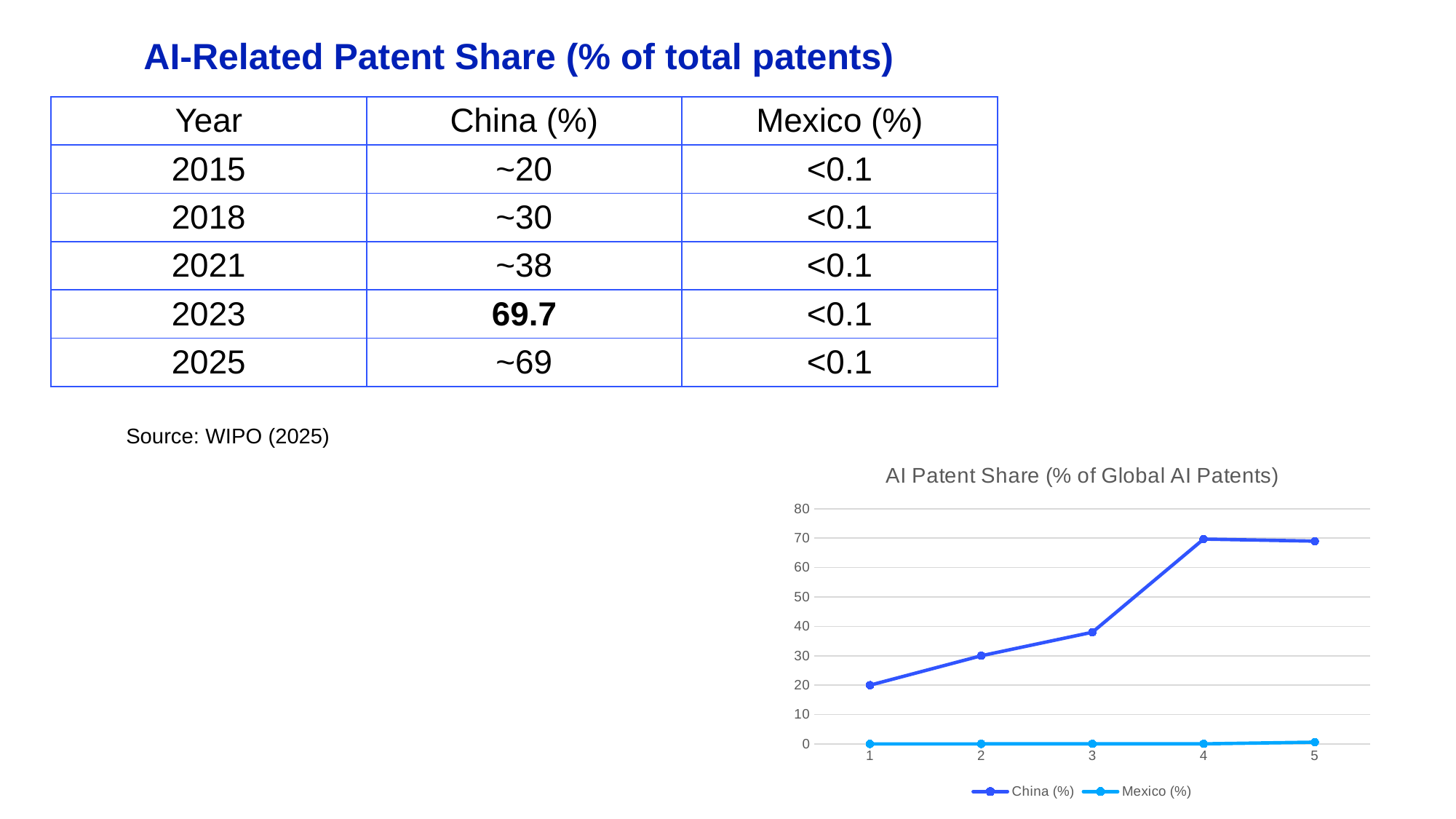
How many series does the chart legend list? 2 In the chart, at which x value is China (%) lowest? 1 In the chart, is the value of China (%) at x = 5 greater or less than 50? greater In the chart, which series has the higher value at x = 4, China (%) or Mexico (%)? China (%) In the chart, is the value of China (%) at x = 4 greater or less than 60? greater In the chart, is the value of China (%) at x = 3 greater or less than 40? less In the chart, does the China (%) series generally rise or fall from x = 1 to x = 4? rise What is the title of the chart? AI Patent Share (% of Global AI Patents) In the chart, what is the value of China (%) at x = 1? 20 How many points are plotted along the x axis for each series in the chart? 5 In the chart, what is the value of China (%) at x = 2? 30 What kind of chart is shown on the slide? line chart